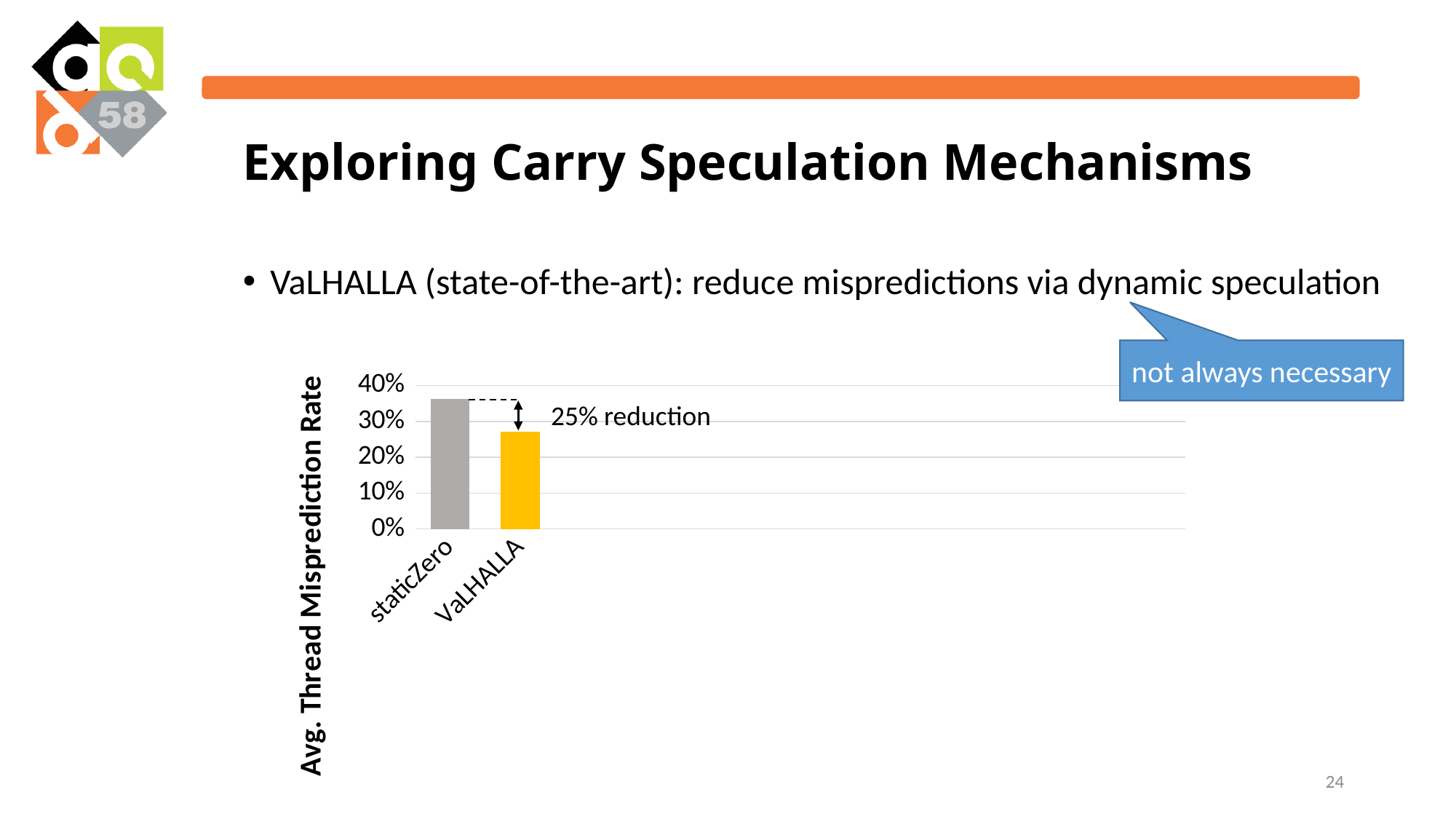
Which has a larger misprediction rate, staticZero or VaLHALLA? staticZero Is the value for staticZero greater or less than 30%? greater How many bars (categories) does the chart show? 2 Which category has the lowest average thread misprediction rate? VaLHALLA Is the value for VaLHALLA greater or less than 30%? less Is the value for VaLHALLA greater or less than 20%? greater Which category has the highest average thread misprediction rate? staticZero What reduction does the annotation between the two bars state? 25% reduction What is the label of the vertical axis of the chart? Avg. Thread Misprediction Rate What kind of chart is shown on the slide? bar chart